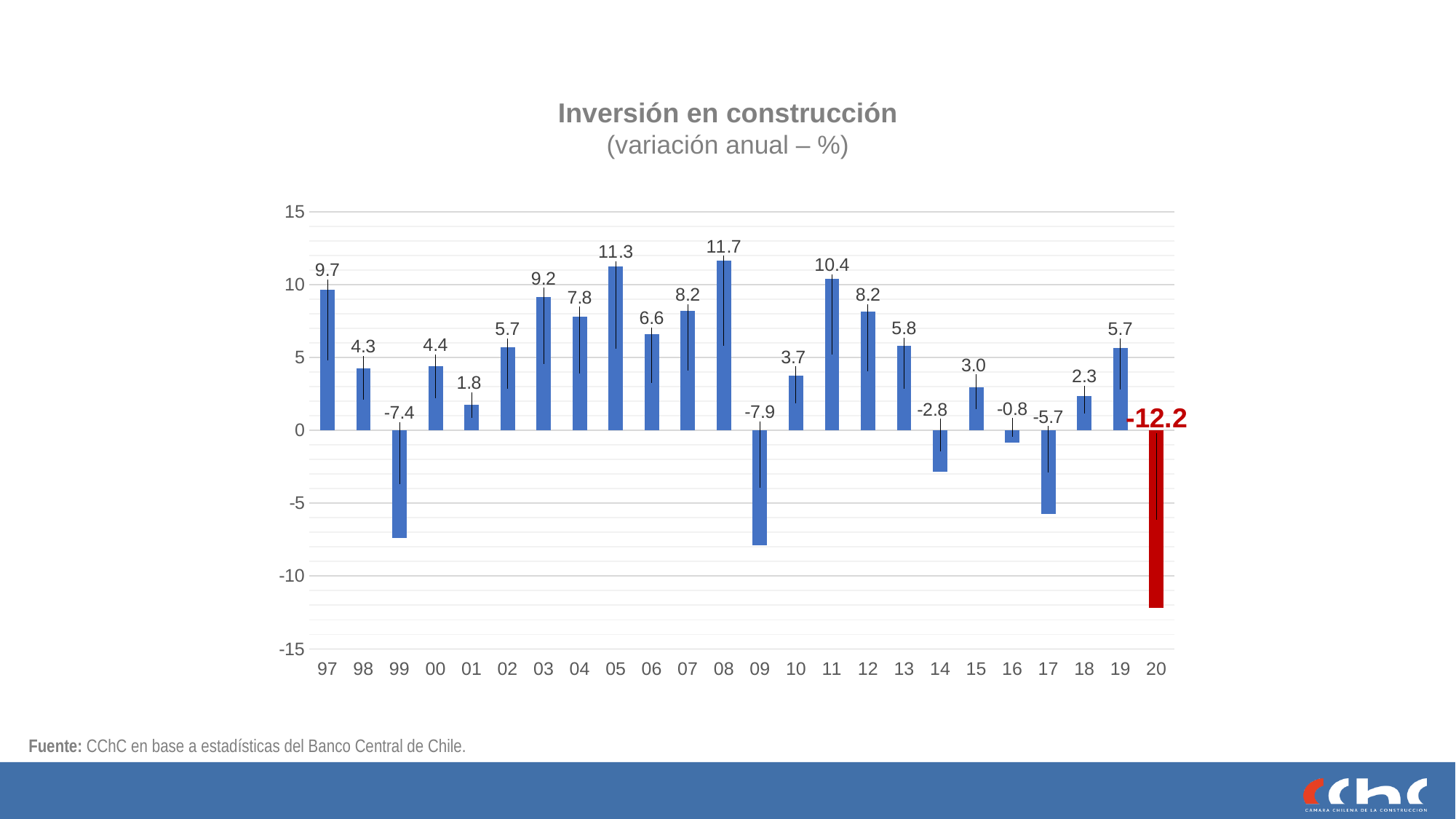
What is the value for 16? -0.8 What is the value for 08? 11.7 What is the value for 99? -7.4 What is the value for 20? -12.2 What is the title of the chart? Inversión en construcción (variación anual – %) Which year has the lowest value? 20 What kind of chart is shown on the slide? bar chart What is the difference between the values for 05 and 06? 4.7 Which year has the highest value? 08 Which is larger, the value for 11 or the value for 12? 11 How many years are shown on the x axis? 24 Which bar is coloured red instead of blue? 20